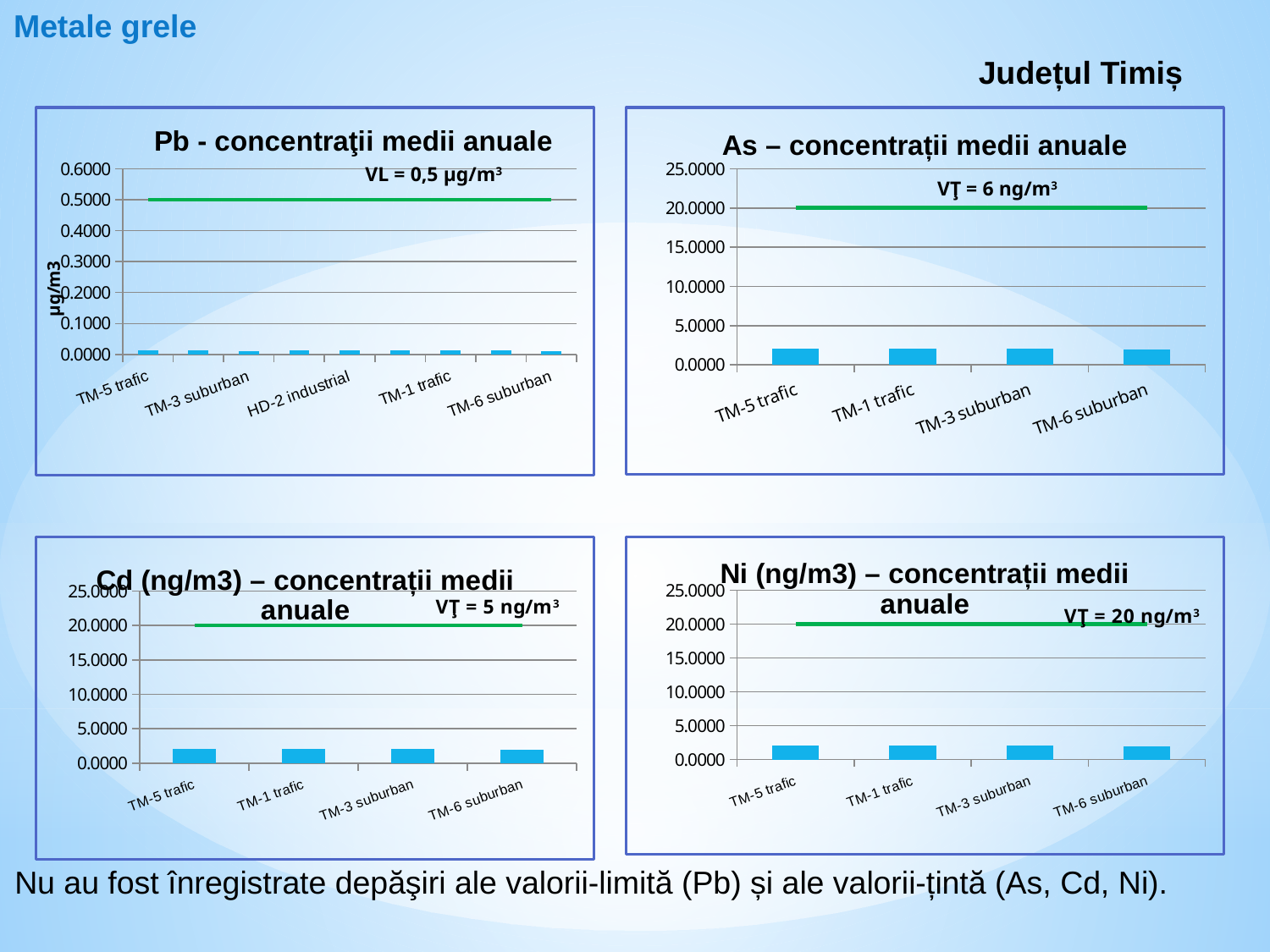
What target value is written next to the green line in the 'Ni (ng/m3) – concentrații medii anuale' chart? VŢ = 20 ng/m³ In the 'Cd (ng/m3) – concentrații medii anuale' chart, how many categories are shown on the x axis? 4 What limit value is written next to the green line in the 'Pb - concentraţii medii anuale' chart? VL = 0,5 µg/m³ In the 'Cd (ng/m3) – concentrații medii anuale' chart, is the value for TM-6 suburban greater or less than 5.0000? less In the 'Ni (ng/m3) – concentrații medii anuale' chart, is the value for TM-3 suburban greater or less than 10.0000? less In the 'Pb - concentraţii medii anuale' chart, is the value for HD-2 industrial greater or less than 0.5000? less In the 'Ni (ng/m3) – concentrații medii anuale' chart, how many categories are shown on the x axis? 4 In the 'As – concentrații medii anuale' chart, how many categories are shown on the x axis? 4 What kind of chart is the 'Pb - concentraţii medii anuale' chart? bar chart